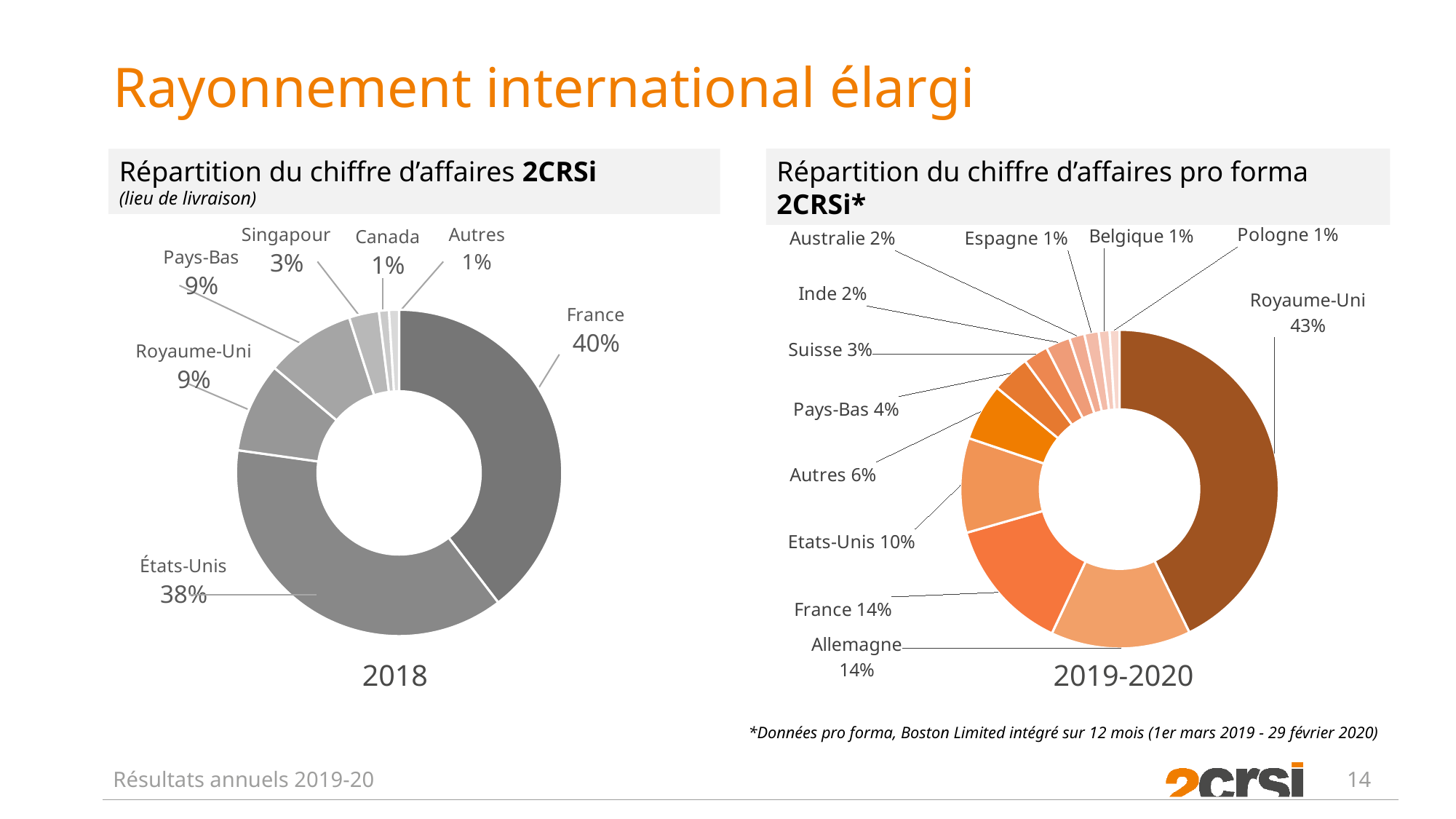
In the 2018 chart on the left, what is the difference between the France and États-Unis shares? 2% In the 2018 chart on the left, which category has the largest share? France What kind of chart is used on the left side of the slide for 2018? Donut (pie) chart In the 2018 chart on the left, what is the share for États-Unis? 38% In the 2019-2020 chart on the right, which category has the largest share? Royaume-Uni In the 2018 chart on the left, what share of revenue does France account for? 40% In the 2018 chart on the left, how many categories are shown? 7 In the 2019-2020 chart on the right, what share does Royaume-Uni account for? 43% In the 2019-2020 chart on the right, how many categories are shown? 12 In the 2019-2020 chart on the right, what is the difference between the Royaume-Uni share and the France share? 29% In the 2019-2020 chart on the right, which is larger, the share for Pays-Bas or the share for Suisse? Pays-Bas In the 2019-2020 chart on the right, what is the share for Etats-Unis? 10%